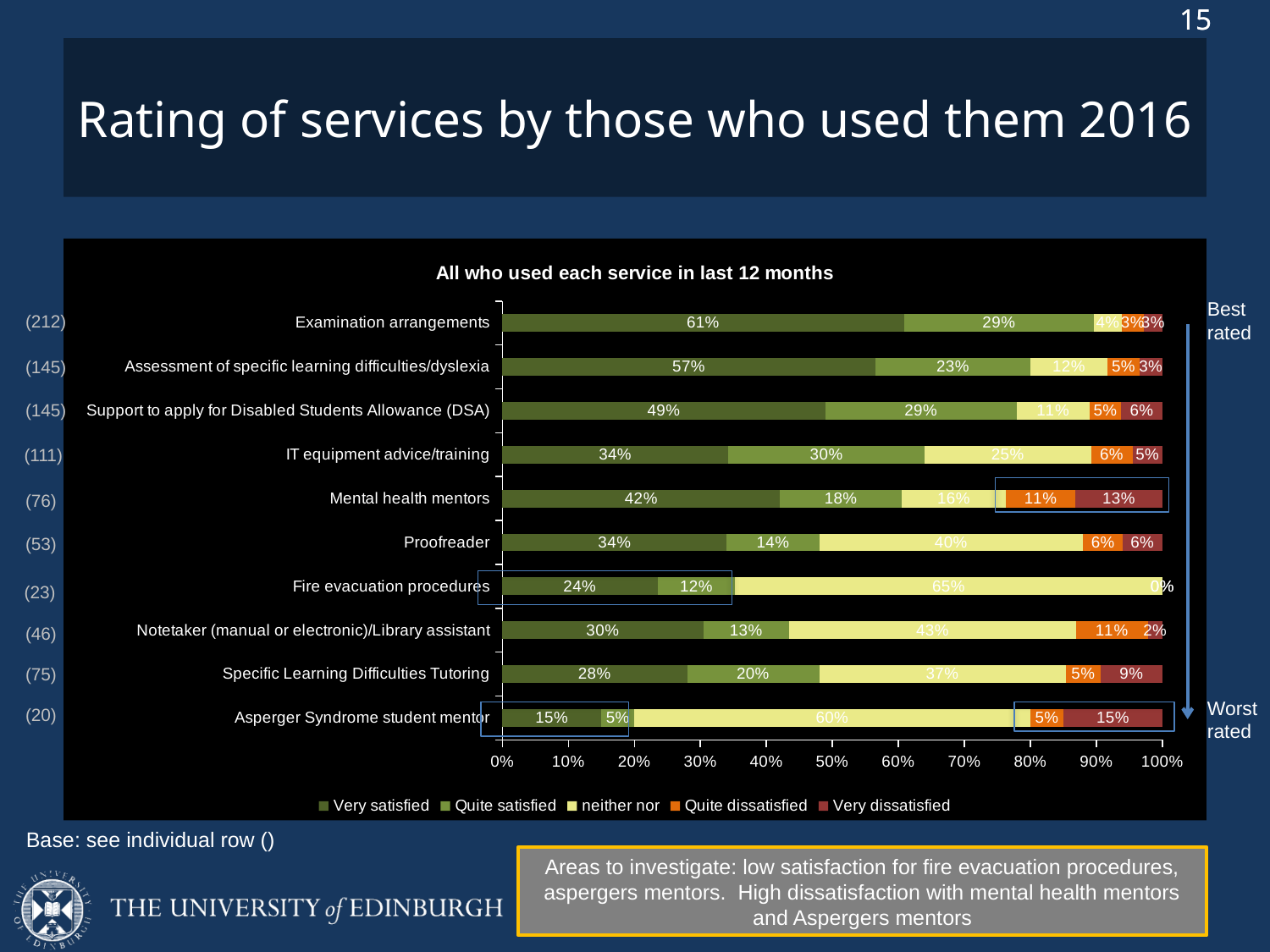
How many series does the legend list? 5 Which service has the highest Very satisfied percentage? Examination arrangements Which has a larger Very dissatisfied percentage: Mental health mentors or Asperger Syndrome student mentor? Asperger Syndrome student mentor What is the title of the chart? All who used each service in last 12 months What is the 'neither nor' value for Fire evacuation procedures? 65% What percentage of those who used Examination arrangements were Very satisfied? 61% What is the Quite dissatisfied value for Mental health mentors? 11% What type of chart is shown on the slide? Stacked bar chart How much higher is the Very satisfied percentage for Examination arrangements than for Assessment of specific learning difficulties/dyslexia? 4% How many services are shown in the chart? 10 Which service has the lowest Very satisfied percentage? Asperger Syndrome student mentor What is the Very dissatisfied value for Specific Learning Difficulties Tutoring? 9%